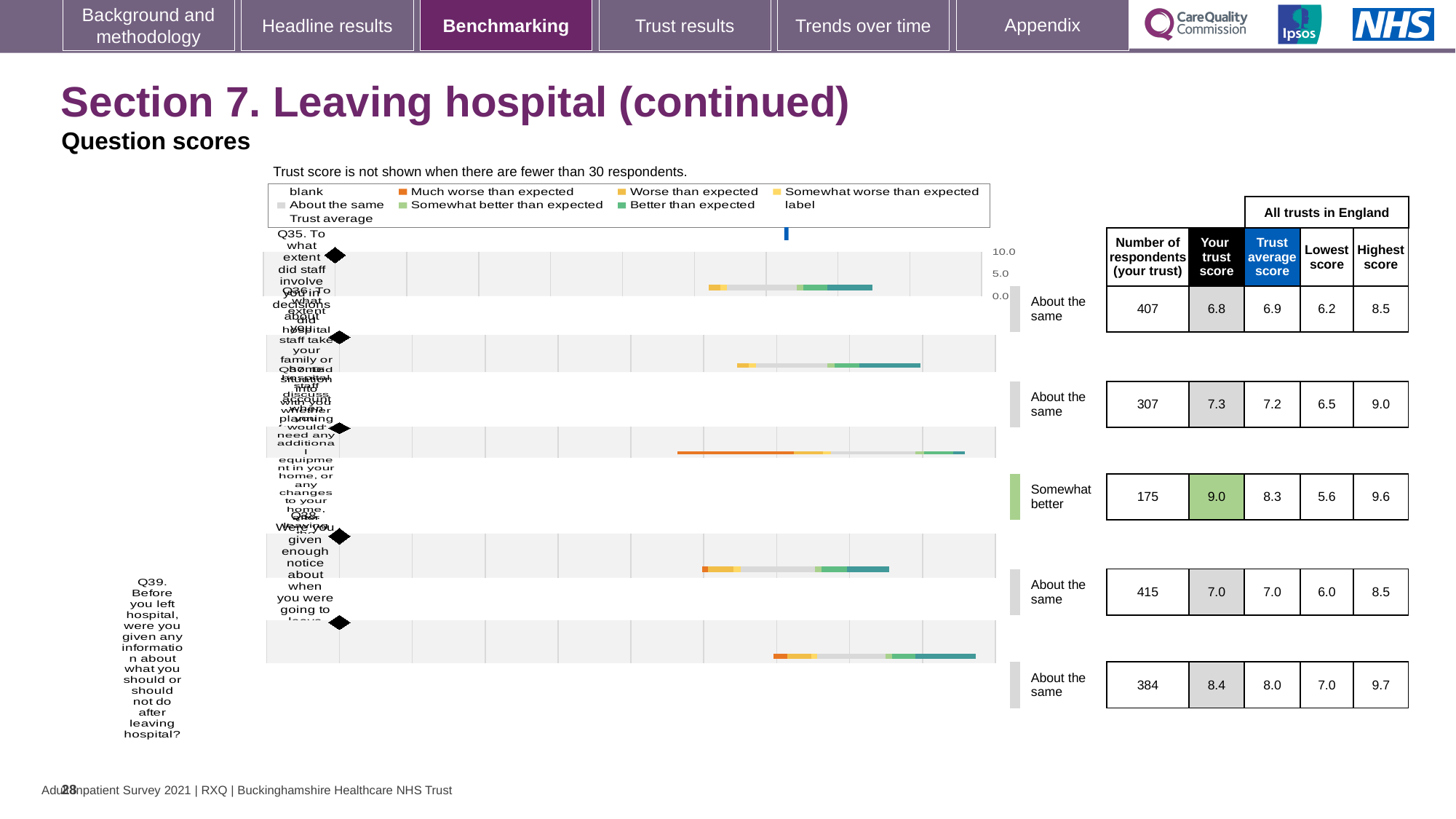
How many respondents answered Q35 (staff involving you in decisions about leaving hospital) at this trust? 407 What is the trust average score across all trusts in England for Q37 (discussing additional equipment or changes to your home)? 8.3 What is the lowest score among all trusts in England for Q38 (enough notice about when you were going to leave hospital)? 6.0 Which is larger for Q36: this trust's score or the trust average score? This trust's score What is the highest score among all trusts in England for Q36 (taking family or home situation into account when planning discharge)? 9.0 How many questions are plotted in the chart? 5 What is the trust score for Q39 (information about what you should or should not do after leaving hospital)? 8.4 Which question has the lowest trust score for this trust? Q35 Which question has the highest trust score for this trust? Q37 What is the difference between the highest and lowest scores across all trusts in England for Q39? 2.7 Which question is rated 'Somewhat better' than expected? Q37 What is the difference between this trust's score and the trust average score for Q37? 0.7